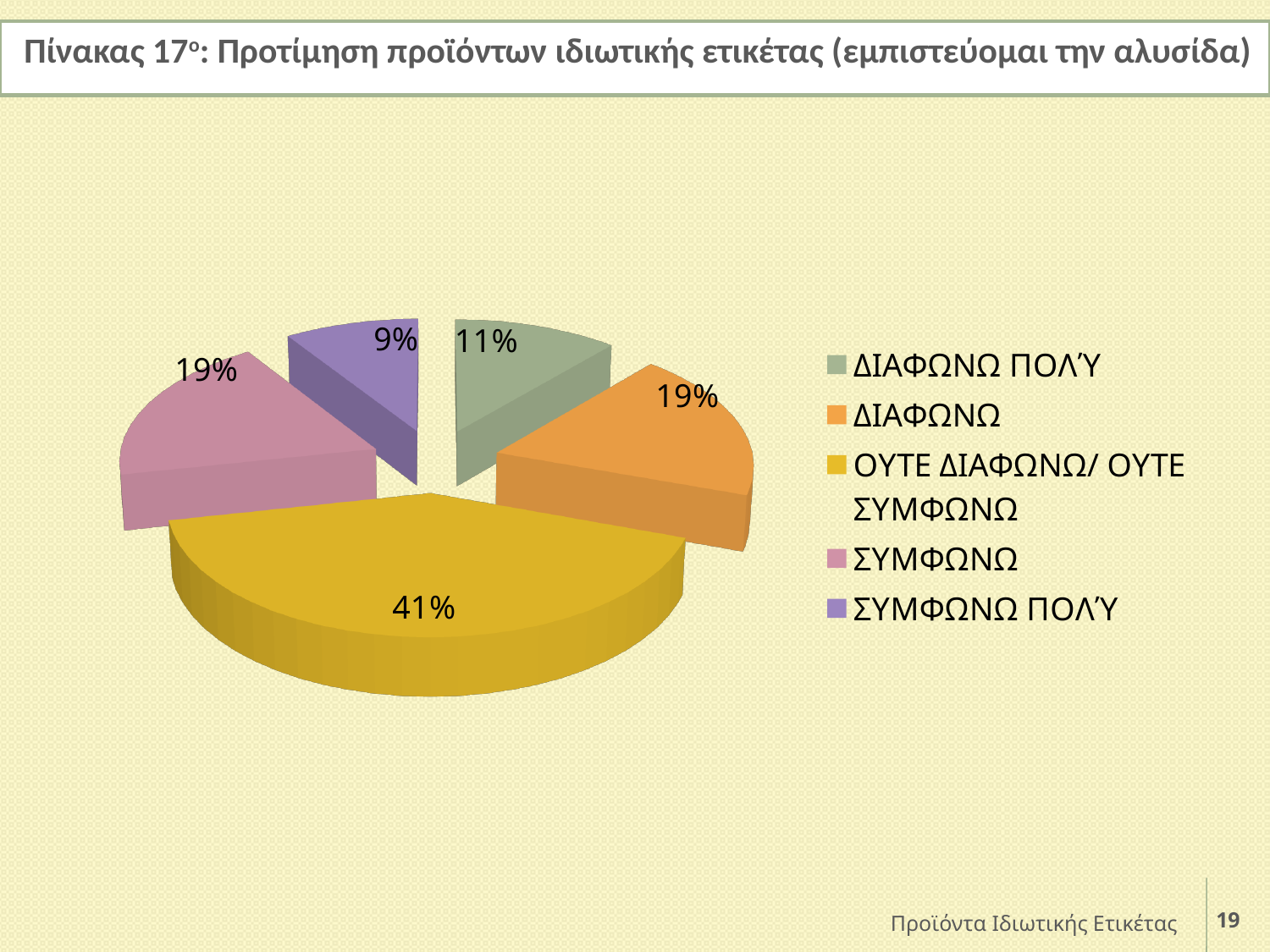
What share of the pie does ΟΥΤΕ ΔΙΑΦΩΝΩ/ ΟΥΤΕ ΣΥΜΦΩΝΩ have? 41% Which category has the largest slice of the pie? ΟΥΤΕ ΔΙΑΦΩΝΩ/ ΟΥΤΕ ΣΥΜΦΩΝΩ What share of the pie does ΔΙΑΦΩΝΩ ΠΟΛΎ have? 11% Which category has the smallest slice of the pie? ΣΥΜΦΩΝΩ ΠΟΛΎ Which is larger, the share for ΔΙΑΦΩΝΩ ΠΟΛΎ or the share for ΣΥΜΦΩΝΩ ΠΟΛΎ? ΔΙΑΦΩΝΩ ΠΟΛΎ What is the difference in percentage points between ΟΥΤΕ ΔΙΑΦΩΝΩ/ ΟΥΤΕ ΣΥΜΦΩΝΩ and ΣΥΜΦΩΝΩ ΠΟΛΎ? 32 percentage points How many categories does the pie chart have? 5 What share of the pie does ΣΥΜΦΩΝΩ ΠΟΛΎ have? 9% What colour is the slice for ΟΥΤΕ ΔΙΑΦΩΝΩ/ ΟΥΤΕ ΣΥΜΦΩΝΩ? Yellow What kind of chart is shown on the slide? Pie chart